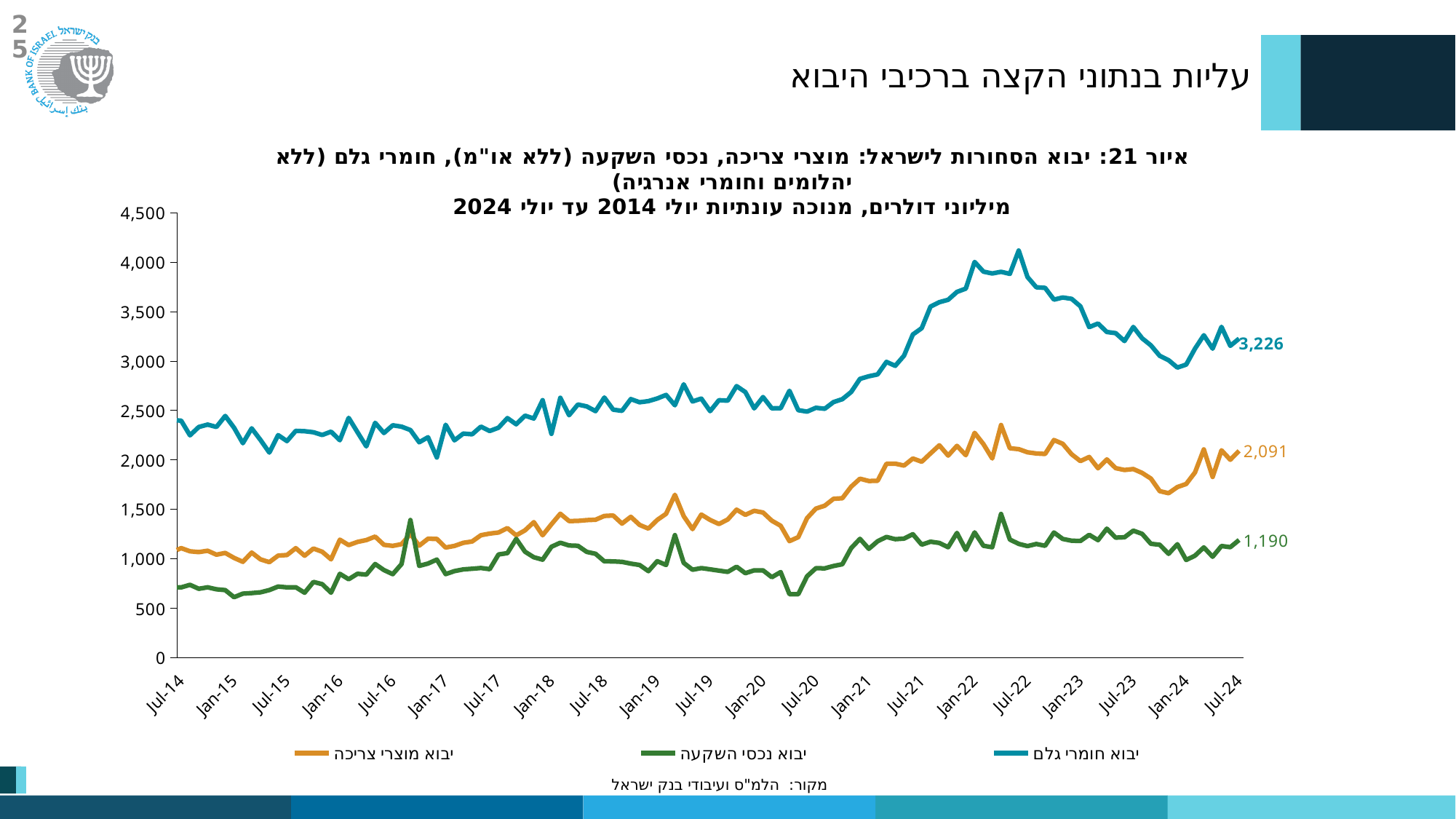
What is the final value (Jul-24) shown for יבוא נכסי השקעה? 1,190 What is the difference between the Jul-24 values of יבוא חומרי גלם and יבוא מוצרי צריכה? 1,135 What is the difference between the Jul-24 values of יבוא מוצרי צריכה and יבוא נכסי השקעה? 901 Which series has the lowest value at the end of the period (Jul-24)? יבוא נכסי השקעה Is the value for יבוא חומרי גלם at Jul-14 greater or less than 2,000? greater What is the final value (Jul-24) shown for יבוא מוצרי צריכה? 2,091 Is the value for יבוא נכסי השקעה at Jul-14 greater or less than 1,000? less What type of chart is shown on the slide? line chart Which series has the highest value at the end of the period (Jul-24)? יבוא חומרי גלם Which colour is used for the יבוא מוצרי צריכה series? orange What is the final value (Jul-24) shown for יבוא חומרי גלם? 3,226 How many series does the legend list? 3